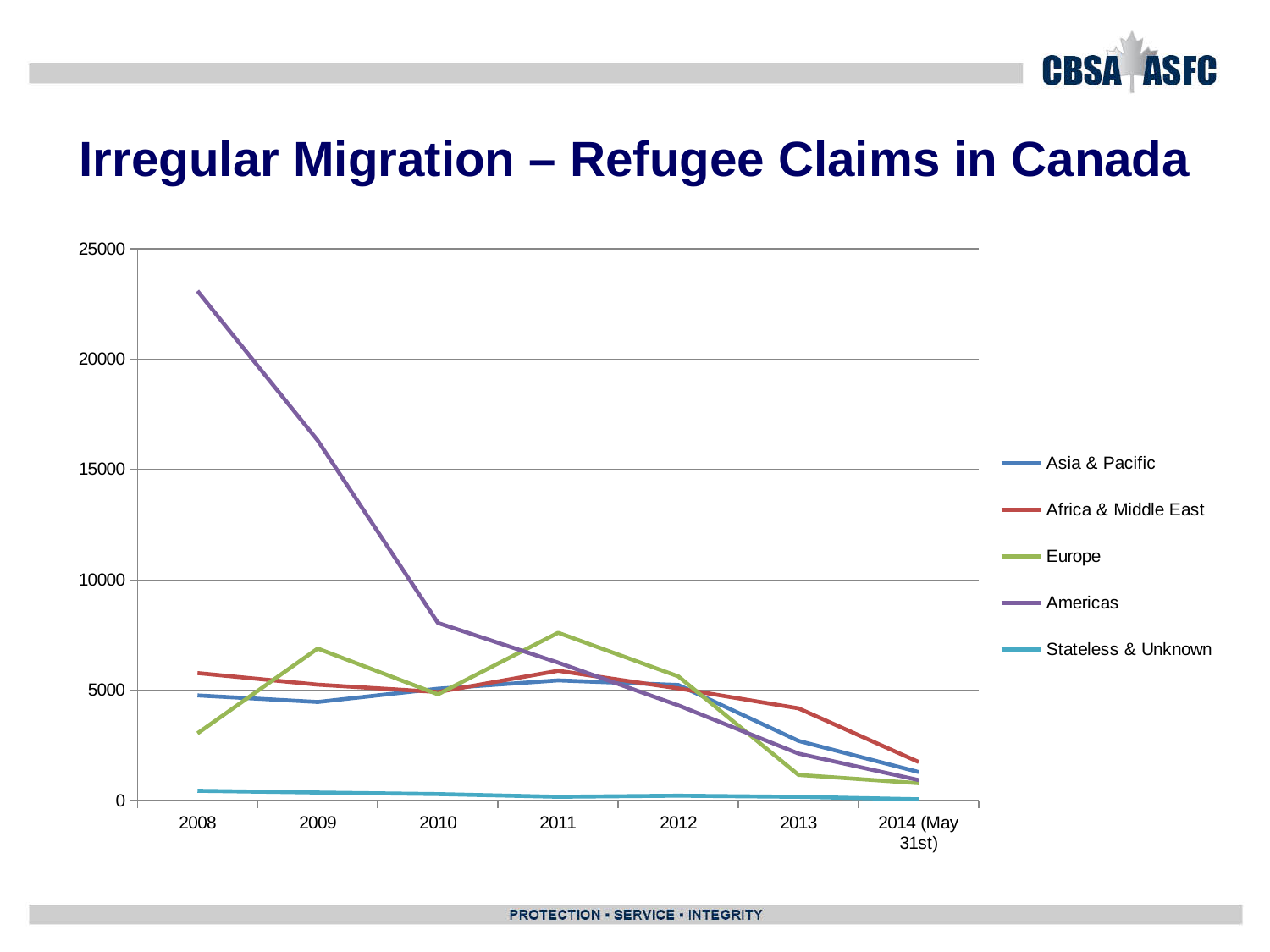
What kind of chart is shown on the slide? Line chart Is the value for Americas in 2008 greater or less than 20000? greater Does the Americas series rise or fall from 2008 to 2014 (May 31st)? Fall What is the title of the chart on the slide? Irregular Migration – Refugee Claims in Canada Which series has the highest value in 2008? Americas Which series has the lowest value in 2008? Stateless & Unknown How many time points are plotted along the x axis? 7 Which is larger in 2011, the value for Europe or the value for Asia & Pacific? Europe How many series does the legend list? 5 In which year does the Americas series reach its highest value? 2008 Is the value for Americas in 2010 greater or less than 10000? less Is the value for Europe in 2011 greater or less than 5000? greater